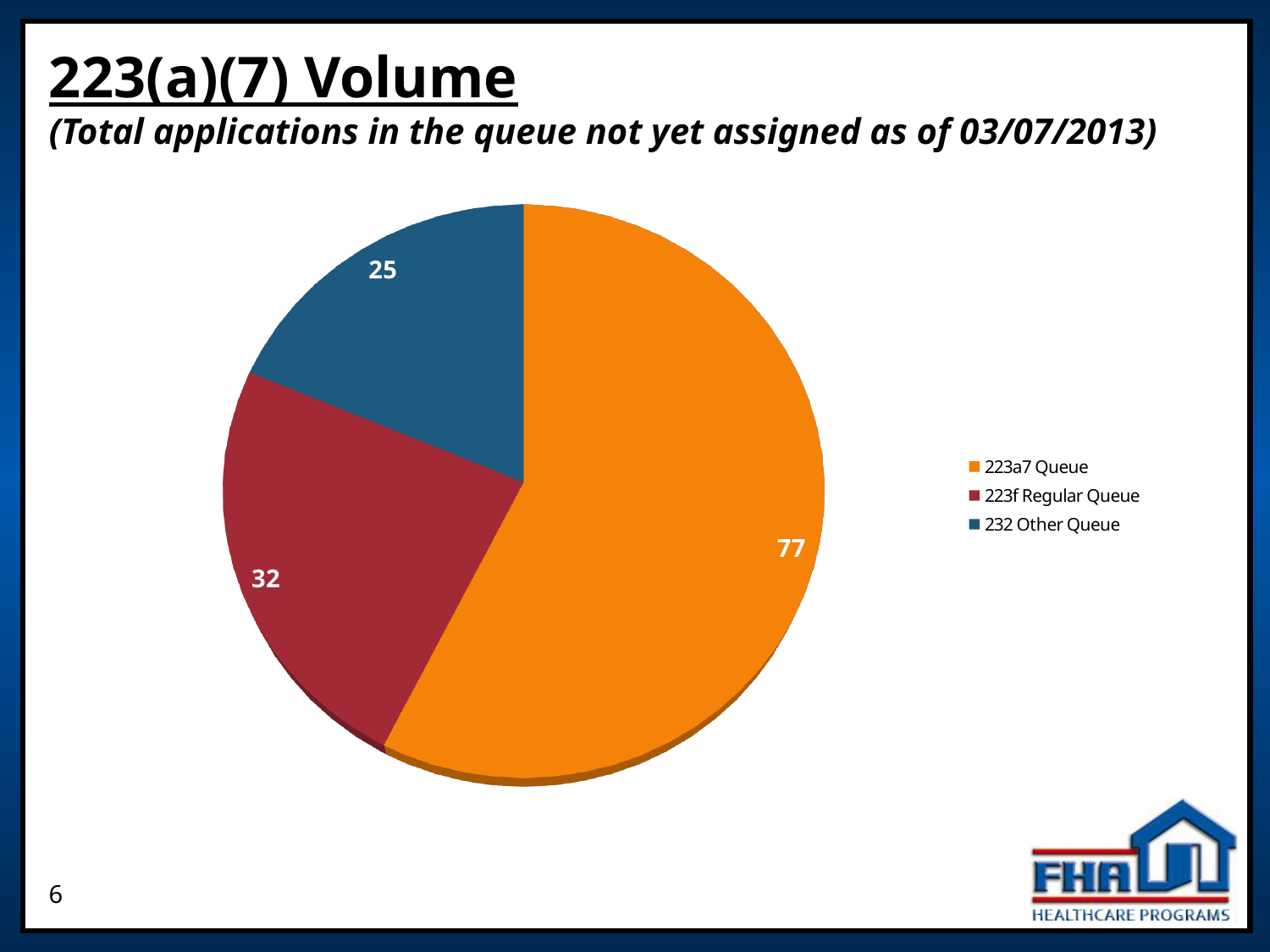
What is the difference between the 223a7 Queue and the 223f Regular Queue values? 45 What is the total of all slices in the pie chart? 134 Which queue has the smallest number of applications? 232 Other Queue What is the value for the 232 Other Queue slice? 25 What type of chart is shown on the slide? pie chart What is the value for the 223f Regular Queue slice? 32 What is the value for the 223a7 Queue slice? 77 What is the difference between the 223f Regular Queue and the 232 Other Queue values? 7 Which is larger, the 223f Regular Queue or the 232 Other Queue? 223f Regular Queue Which queue has the largest number of applications? 223a7 Queue What colour is the 223a7 Queue slice? orange How many slices does the pie chart have? 3